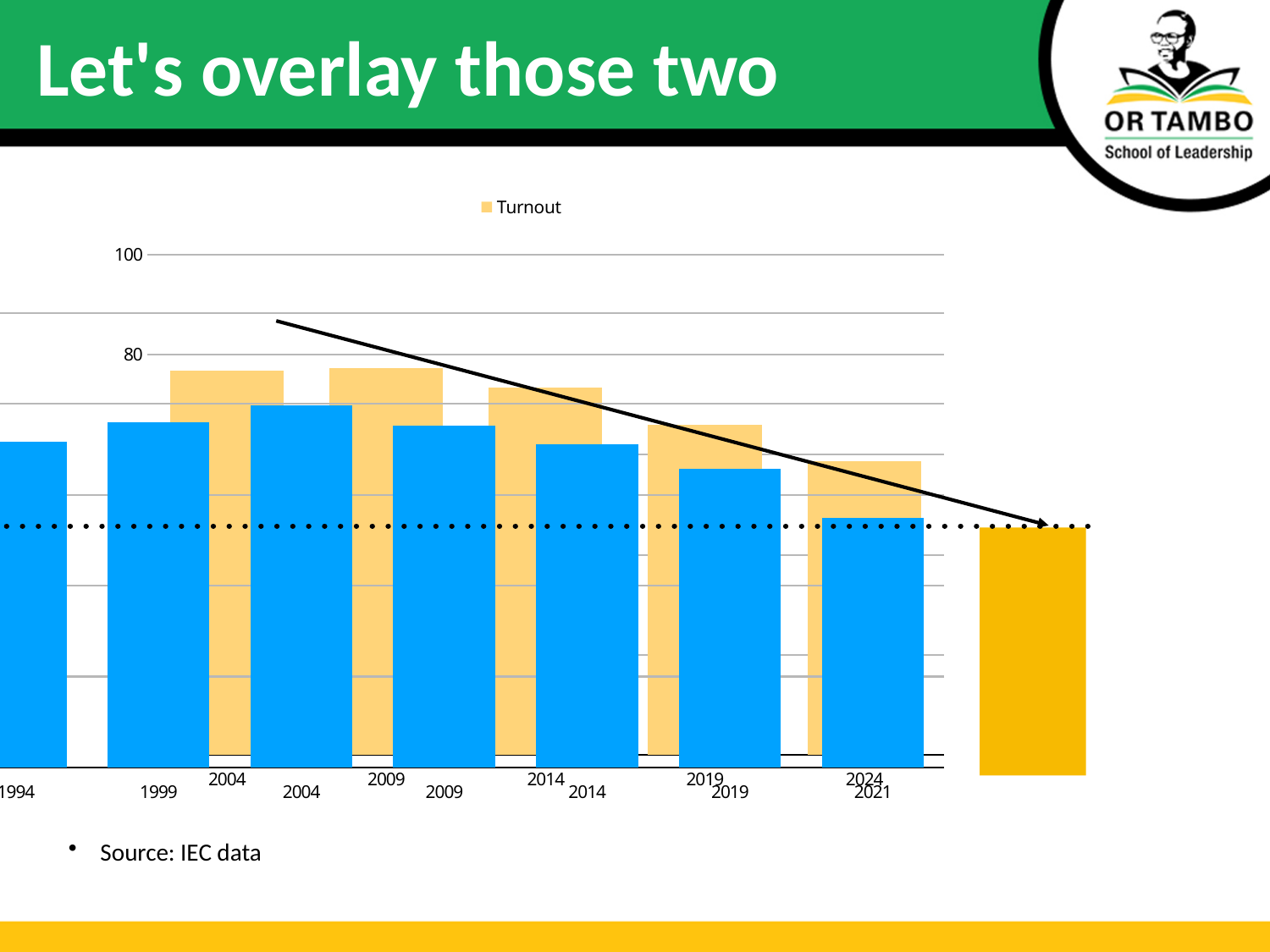
Is the Turnout value for 2019 greater or less than 70? less What kind of chart is shown on the slide? bar chart What is the name of the series shown in the legend? Turnout Among the blue bars, which year has the lowest value? 2021 How many series does the legend list? 1 Among the blue bars, which year has the highest value? 2004 Is the Turnout value for 2024 greater or less than 50? greater Do the Turnout values rise or fall from 2009 to 2024? fall Is the Turnout value for 2004 greater or less than 80? less How many Turnout bars (the light yellow bars) are plotted for labelled years? 5 Which year has the lowest Turnout among the light yellow bars? 2024